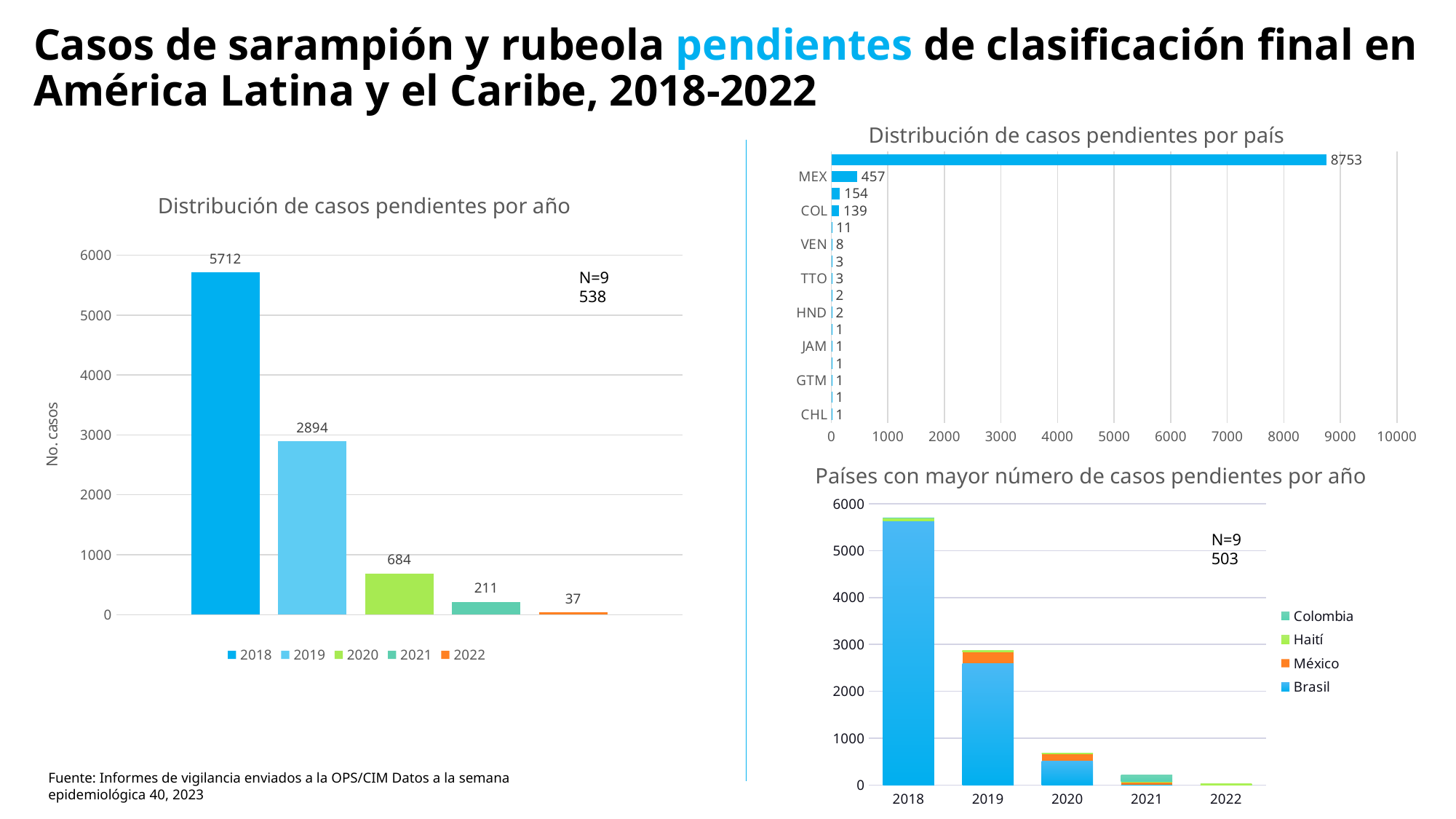
In the chart 'Distribución de casos pendientes por año', do the values rise or fall from 2018 to 2022? fall In the chart 'Distribución de casos pendientes por país', what is the value for COL? 139 In the chart 'Distribución de casos pendientes por país', what is the largest value shown? 8753 In the chart 'Países con mayor número de casos pendientes por año', how many series does the legend list? 4 In the chart 'Distribución de casos pendientes por año', how many pending cases are shown for 2018? 5712 In the chart 'Distribución de casos pendientes por país', what is the value for MEX? 457 In the chart 'Distribución de casos pendientes por año', which year has the lowest number of pending cases? 2022 In the chart 'Países con mayor número de casos pendientes por año', is the total stacked value for 2018 greater or less than 5000? greater In the chart 'Distribución de casos pendientes por año', what is the difference between the 2018 and 2019 values? 2818 In the chart 'Distribución de casos pendientes por año', how many pending cases are shown for 2020? 684 In the chart 'Distribución de casos pendientes por país', which is larger, the value for VEN or the value for TTO? VEN In the chart 'Distribución de casos pendientes por año', how many years are plotted? 5